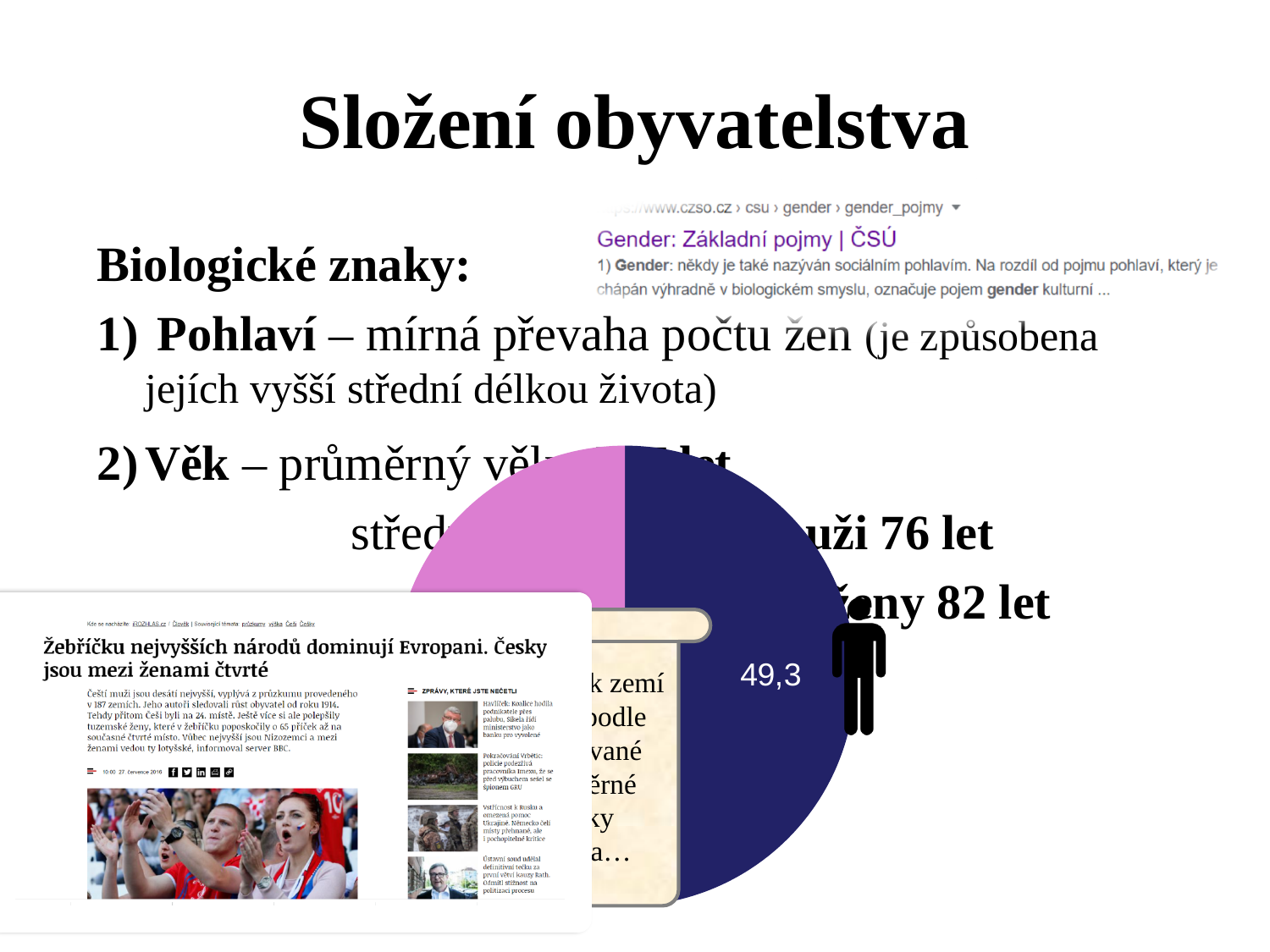
What kind of chart is shown on the slide? pie chart What value is printed on the dark blue slice of the pie chart? 49,3 What colour is the other, unlabelled slice of the pie chart? pink How many slices does the pie chart have? 2 What colour is the slice of the pie chart labelled 49,3? dark blue